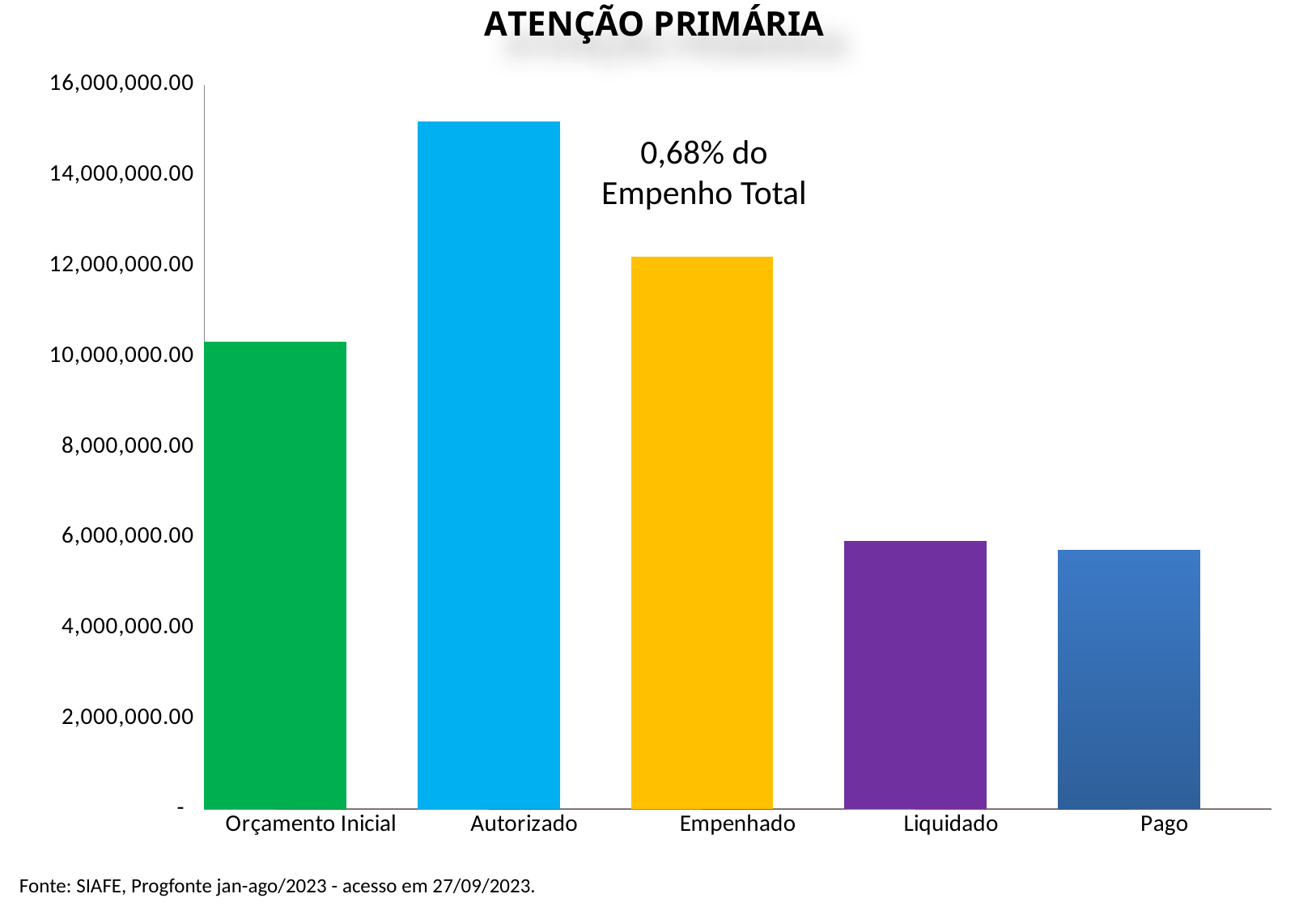
Is the value for Pago greater or less than 8,000,000.00? less What is the title of the chart? ATENÇÃO PRIMÁRIA Which is larger, the value for Orçamento Inicial or the value for Empenhado? Empenhado Which category has the highest value in the chart? Autorizado Which is larger, the value for Autorizado or the value for Empenhado? Autorizado Is the value for Orçamento Inicial greater or less than 8,000,000.00? greater What type of chart is shown on the slide? bar chart Which is larger, the value for Orçamento Inicial or the value for Liquidado? Orçamento Inicial Is the value for Empenhado greater or less than 14,000,000.00? less How many categories are shown on the x axis of the chart? 5 What percentage of the total commitment (Empenho Total) does the annotation on the chart state? 0,68%